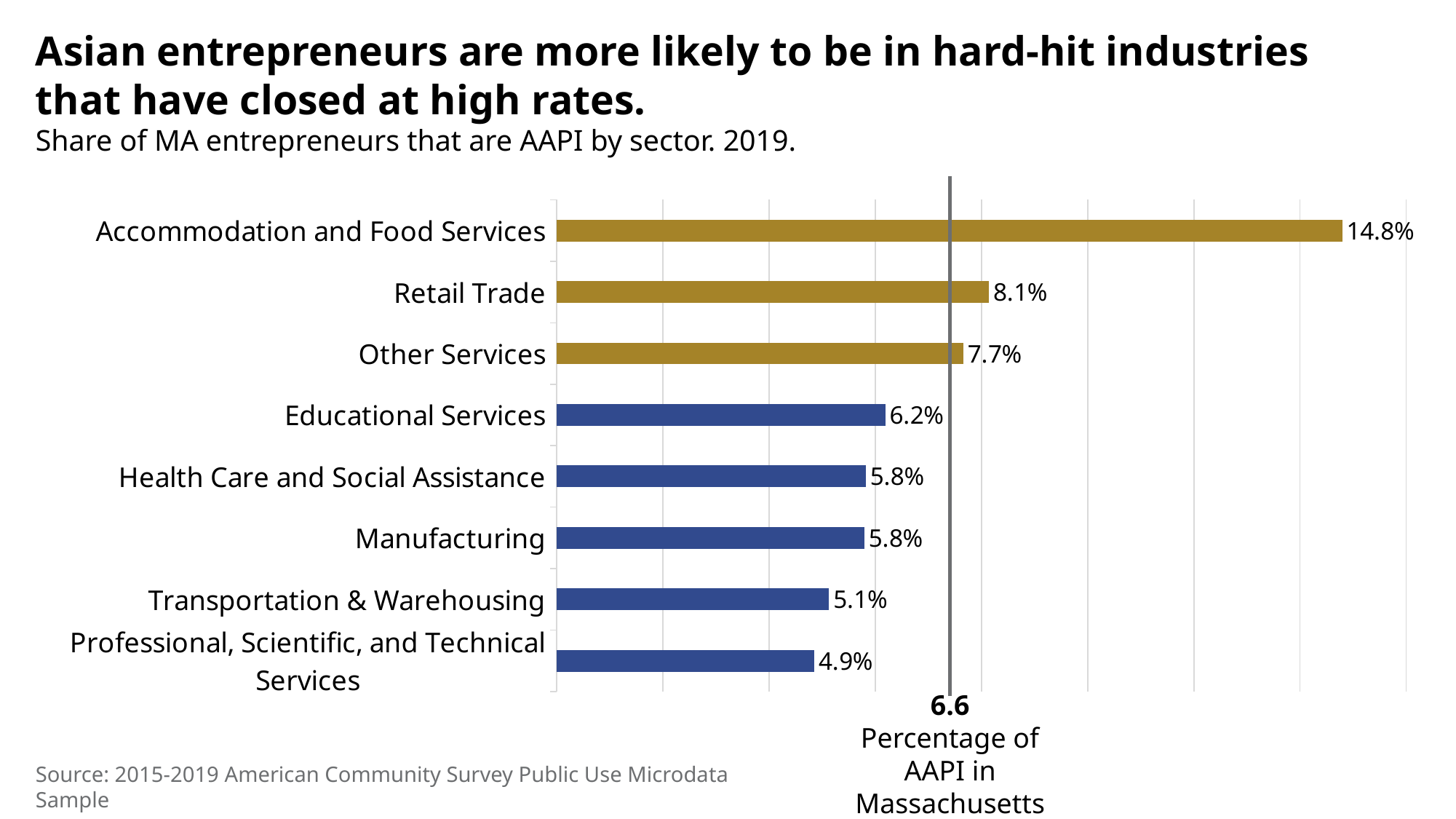
Which sector has the lowest share of AAPI entrepreneurs? Professional, Scientific, and Technical Services What is the share of MA entrepreneurs that are AAPI in Accommodation and Food Services? 14.8% What is the value for Transportation & Warehousing? 5.1% How many sectors are shown with gold-coloured bars? 3 What value does the vertical reference line mark for the percentage of AAPI in Massachusetts? 6.6 Which is larger, the value for Other Services or the value for Educational Services? Other Services What is the difference between the values for Accommodation and Food Services and Retail Trade? 6.7% Which sector has the highest share of AAPI entrepreneurs? Accommodation and Food Services What kind of chart is shown on the slide? Bar chart What is the value for Professional, Scientific, and Technical Services? 4.9% How many sectors are shown in the chart? 8 What is the value for Retail Trade? 8.1%